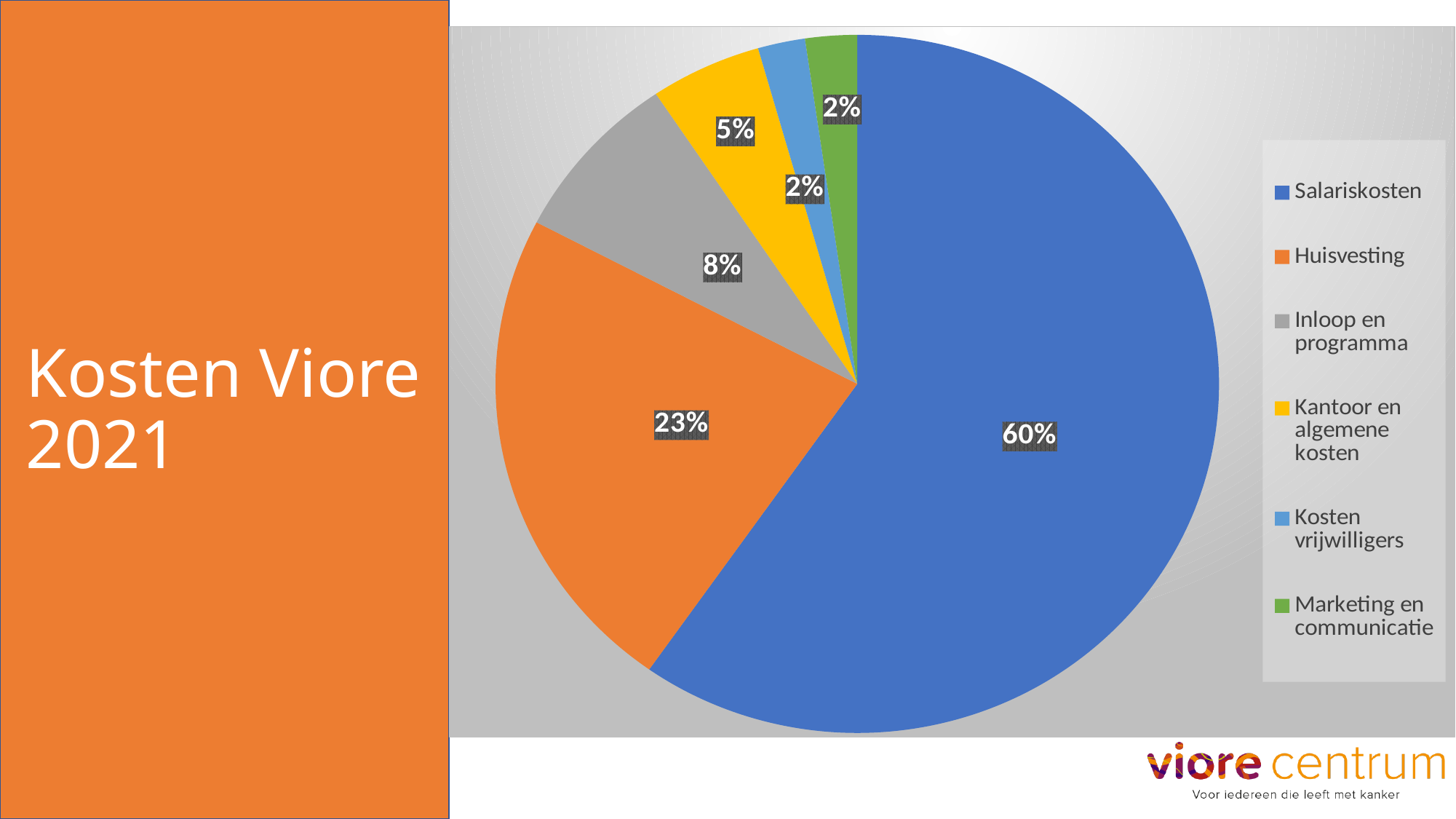
Which is larger, Inloop en programma or Kantoor en algemene kosten? Inloop en programma How many categories does the pie chart show? 6 Which category has the largest slice of the pie? Salariskosten What share of the pie does Salariskosten take? 60% What share of the pie does Kantoor en algemene kosten take? 5% What kind of chart is shown on the slide? Pie chart What is the combined share of Salariskosten and Huisvesting? 83% What share of the pie does Huisvesting take? 23% What colour is the Huisvesting slice? Orange What is the difference in percentage points between Salariskosten and Huisvesting? 37